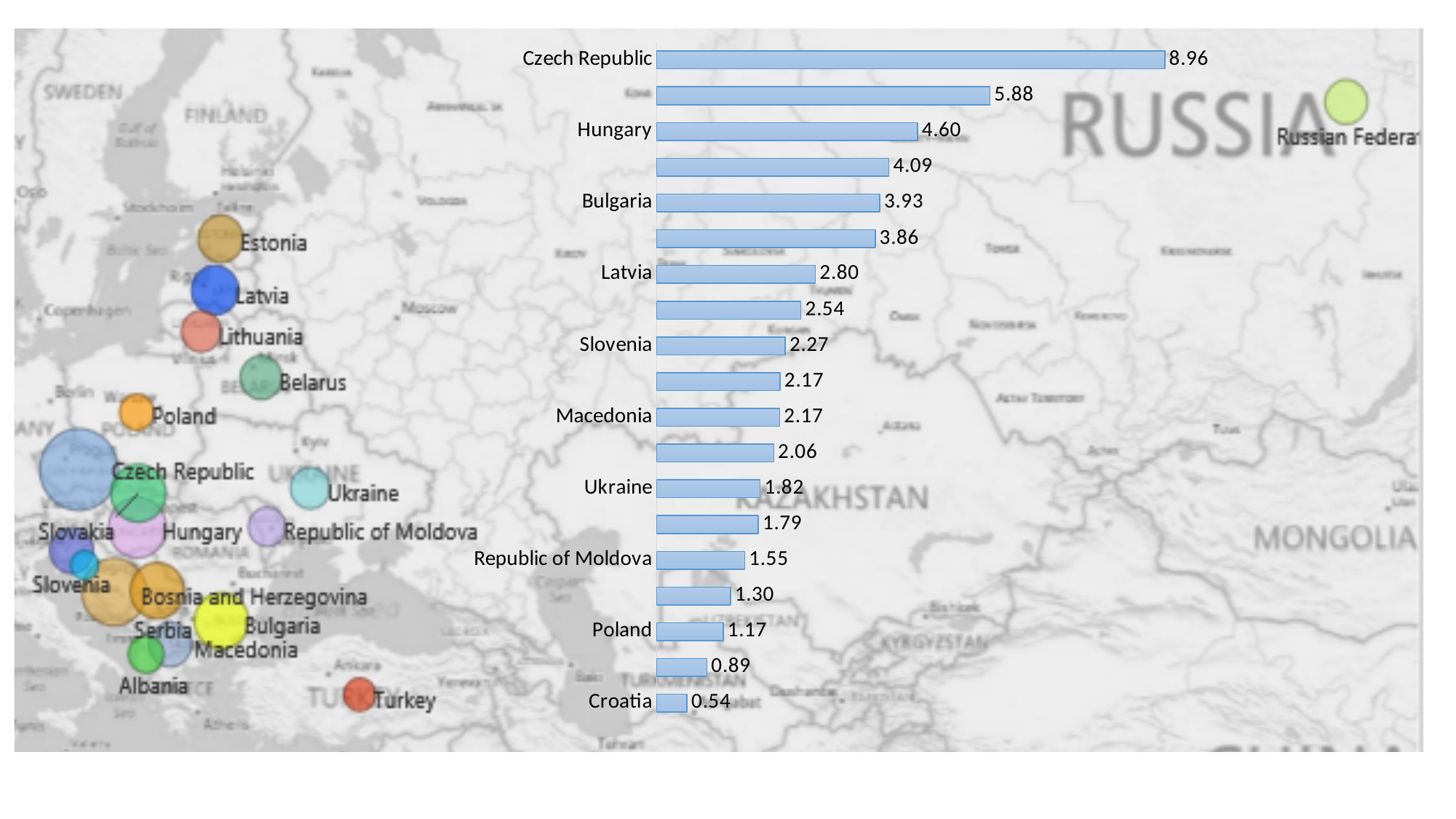
What is the value for Republic of Moldova in the bar chart? 1.55 What is the difference between the values for Latvia and Poland in the bar chart? 1.63 What is the value for Hungary in the bar chart? 4.60 Which country has the highest value in the bar chart? Czech Republic What is the difference between the values for Czech Republic and Hungary in the bar chart? 4.36 What kind of chart is shown on the right side of the slide? Bar chart What is the value for Croatia in the bar chart? 0.54 How many bars are plotted in the bar chart? 19 What is the value for Czech Republic in the bar chart? 8.96 Which country has the lowest value in the bar chart? Croatia In the bar chart, which has a larger value, Bulgaria or Slovenia? Bulgaria Do the bar values increase or decrease going from the top of the chart to the bottom? Decrease